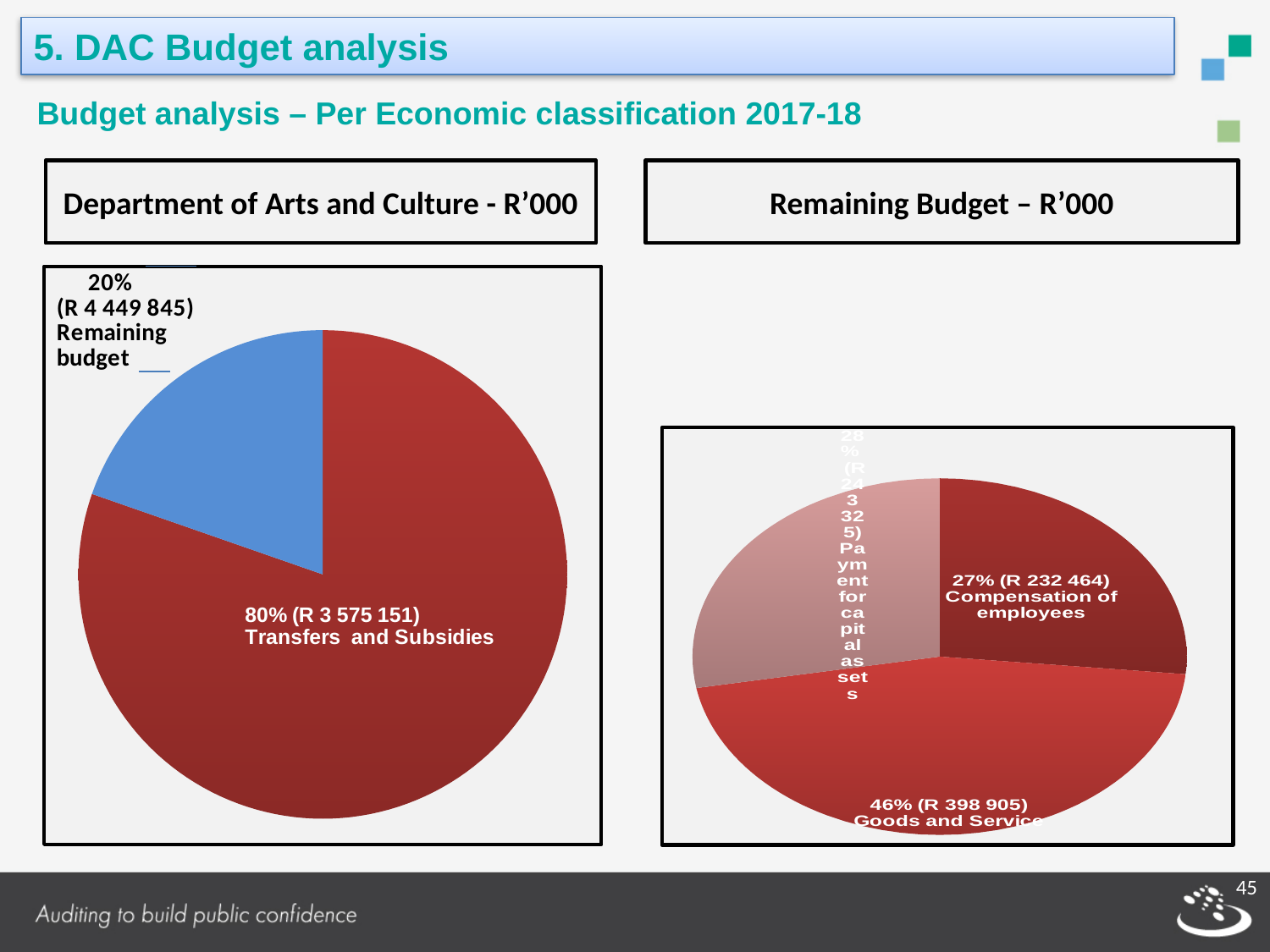
In the 'Department of Arts and Culture - R'000' chart, which slice is larger: Transfers and Subsidies or Remaining budget? Transfers and Subsidies In the 'Department of Arts and Culture - R'000' chart, what value is shown for Transfers and Subsidies? R 3 575 151 In the 'Remaining Budget – R'000' chart, how many slices does the pie have? 3 In the 'Remaining Budget – R'000' chart, what share of the pie is Goods and Services? 46% In the 'Department of Arts and Culture - R'000' chart, how many slices does the pie have? 2 What kind of chart is the 'Department of Arts and Culture - R'000' chart on the left? Pie chart In the 'Remaining Budget – R'000' chart, what value is shown for Compensation of employees? R 232 464 In the 'Remaining Budget – R'000' chart, which category has the largest slice? Goods and Services In the 'Department of Arts and Culture - R'000' chart, what share of the pie is Transfers and Subsidies? 80% In the 'Remaining Budget – R'000' chart, what is the difference in percentage points between Goods and Services and Compensation of employees? 19 percentage points In the 'Department of Arts and Culture - R'000' chart, what share of the pie is the Remaining budget? 20% In the 'Remaining Budget – R'000' chart, which category has the smallest slice? Compensation of employees